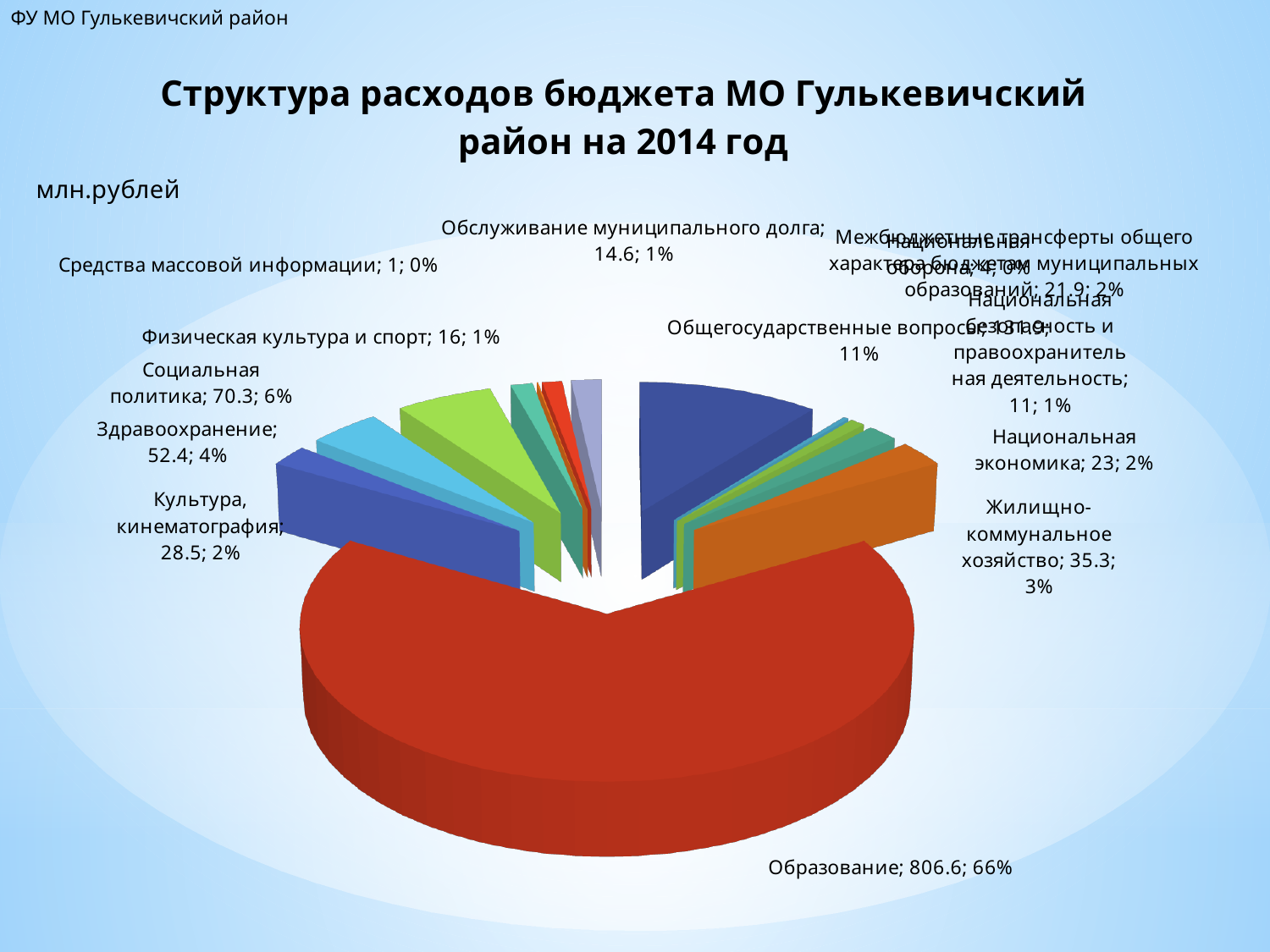
What is the difference between the values for Социальная политика and Здравоохранение? 17.9 Which category has the smallest value? Средства массовой информации What is the value for Социальная политика? 70.3 What is the value for Жилищно-коммунальное хозяйство? 35.3 What is the value for Образование? 806.6 Which is larger, Социальная политика or Здравоохранение? Социальная политика In what units are the values on the chart given? млн.рублей What share of the pie does Здравоохранение take? 4% What share of the pie does Образование take? 66% What kind of chart is shown on the slide? Pie chart Which category has the largest value? Образование What is the value for Здравоохранение? 52.4